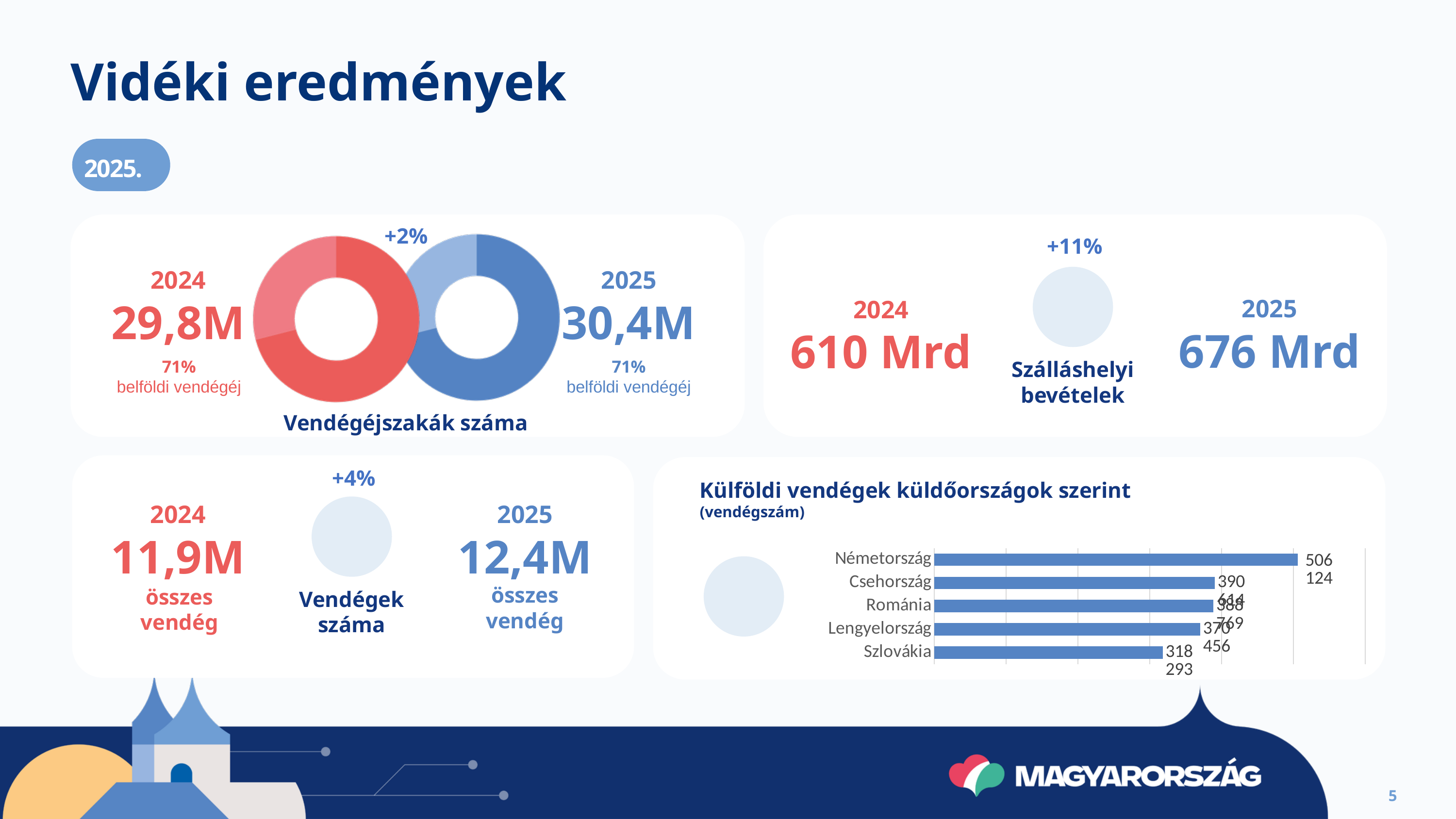
What unit is given in parentheses under the title of the 'Külföldi vendégek küldőországok szerint' chart? vendégszám In the 'Külföldi vendégek küldőországok szerint' chart, which has the larger value, Németország or Csehország? Németország In the 'Külföldi vendégek küldőországok szerint' chart, which country has the highest number of guests? Németország In the 'Külföldi vendégek küldőországok szerint' chart, do the bar values rise or fall going from the top country to the bottom country? fall What total value is shown next to the 2025 donut in the 'Vendégéjszakák száma' chart? 30,4M What kind of chart is 'Külföldi vendégek küldőországok szerint'? bar chart In the 'Vendégéjszakák száma' donut charts, what share of the 2024 guest nights is 'belföldi vendégéj'? 71% In the 'Külföldi vendégek küldőországok szerint' chart, what is the value for Szlovákia? 318 293 In the 'Külföldi vendégek küldőországok szerint' chart, which country has the lowest number of guests? Szlovákia In the 'Külföldi vendégek küldőországok szerint' chart, what is the difference between the values for Németország and Szlovákia? 187 831 How many countries are shown in the 'Külföldi vendégek küldőországok szerint' chart? 5 In the 'Külföldi vendégek küldőországok szerint' chart, what is the value for Németország? 506 124